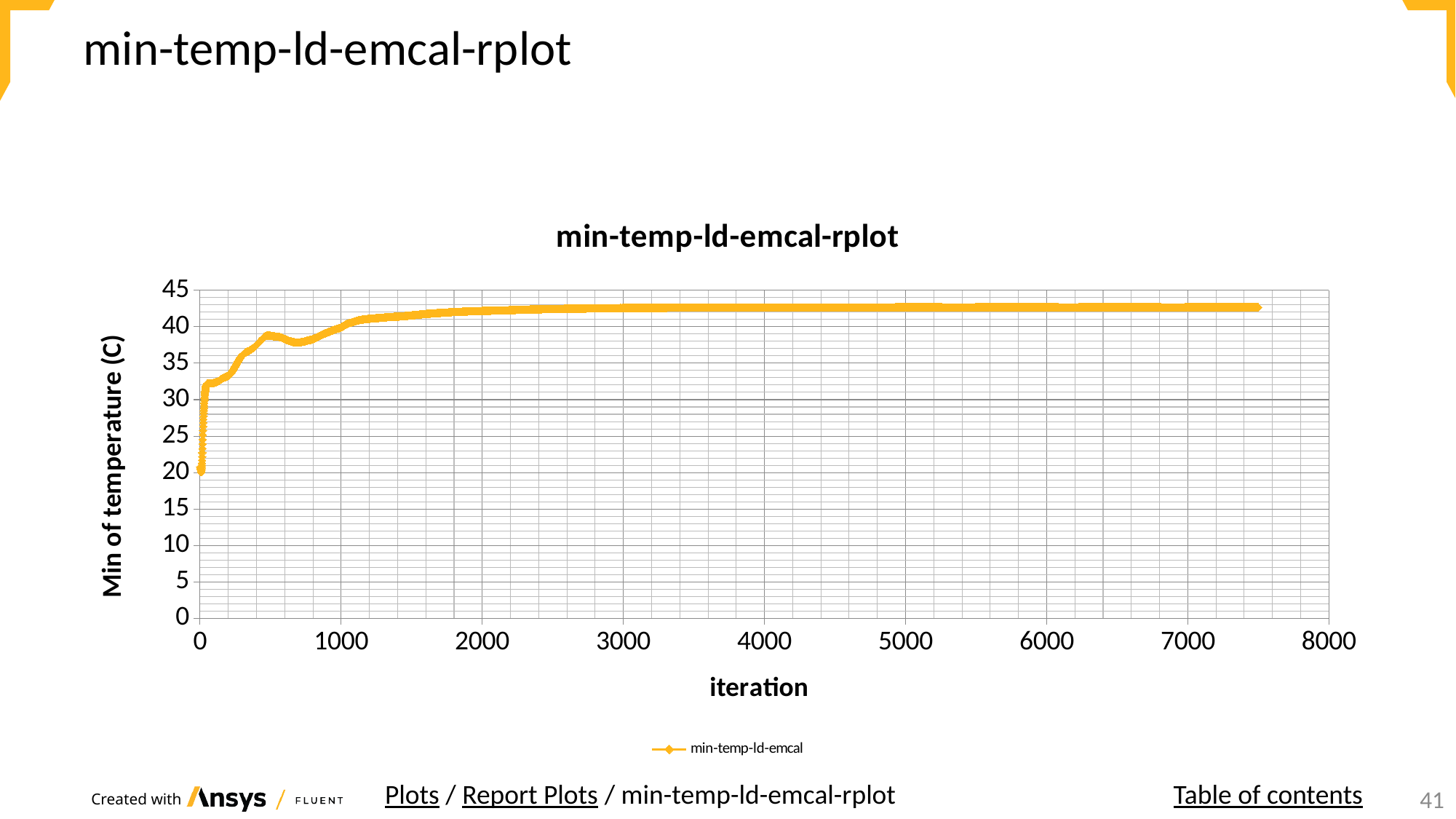
How many series does the legend list? 1 Is the value for min-temp-ld-emcal at iteration 7000 greater or less than 40? greater Is the value for min-temp-ld-emcal at iteration 500 greater or less than 40? less What kind of chart is shown on the slide? line chart Do the values generally rise or fall as the iteration increases? rise Is the value for min-temp-ld-emcal at iteration 2000 greater or less than 35? greater At which end of the x axis does the series reach its lowest value, the start (iteration 0) or the end (around iteration 7500)? the start (iteration 0) Which is larger, the value at iteration 1000 or the value at iteration 0? iteration 1000 What is the label of the y axis? Min of temperature (C) What is the title of the chart? min-temp-ld-emcal-rplot